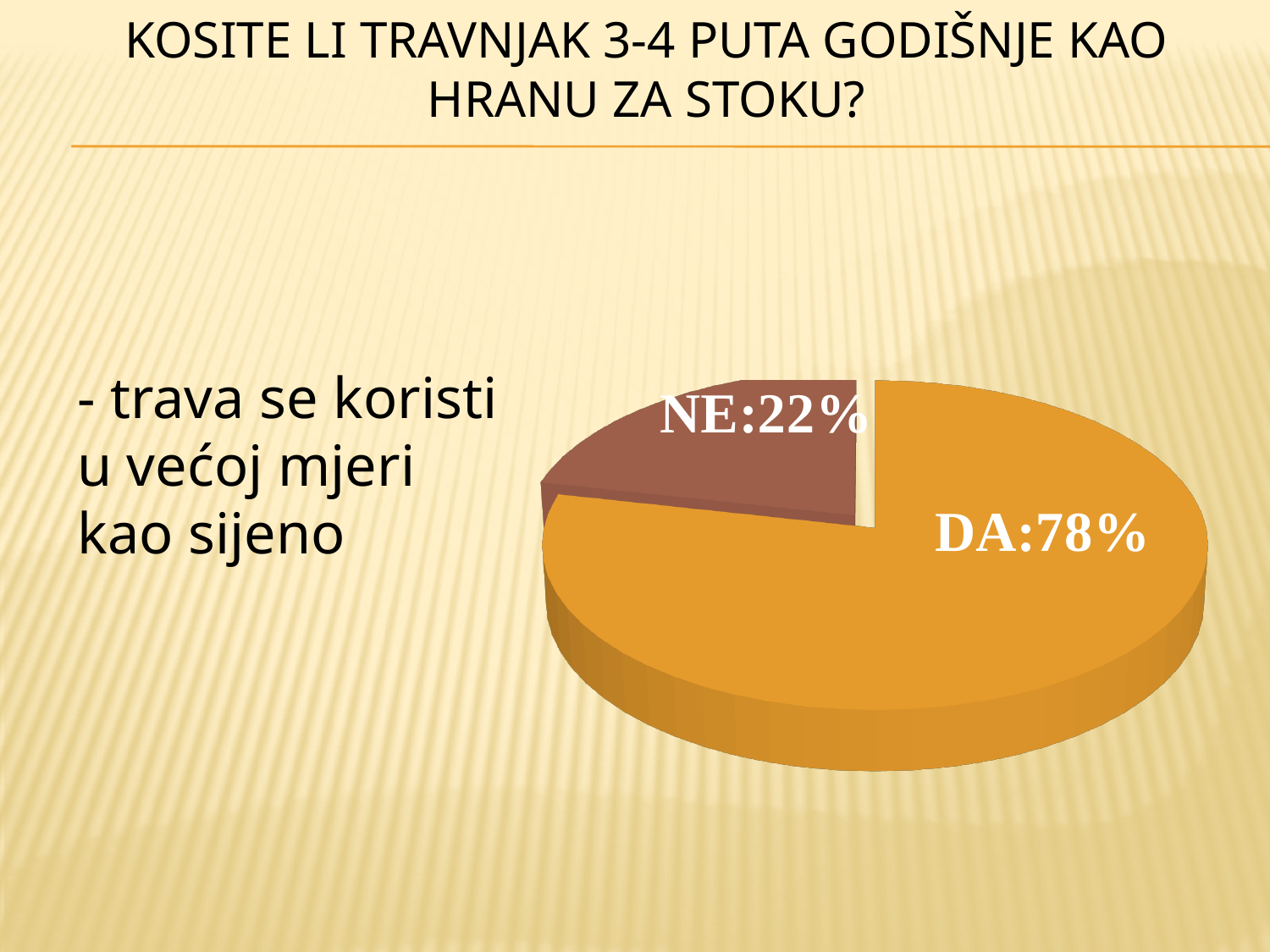
Which is larger, the DA slice or the NE slice? DA What is the value for NE in the pie chart? 22% What is the difference between the DA and NE shares? 56% What kind of chart is shown on the slide? pie chart Which slice of the pie chart is the smallest? NE What is the value for DA in the pie chart? 78% Which slice of the pie chart is the largest? DA How many slices does the pie chart have? 2 What share of the pie does the NE slice represent? 22% What colour is the DA slice of the pie chart? orange What colour is the NE slice of the pie chart? brown